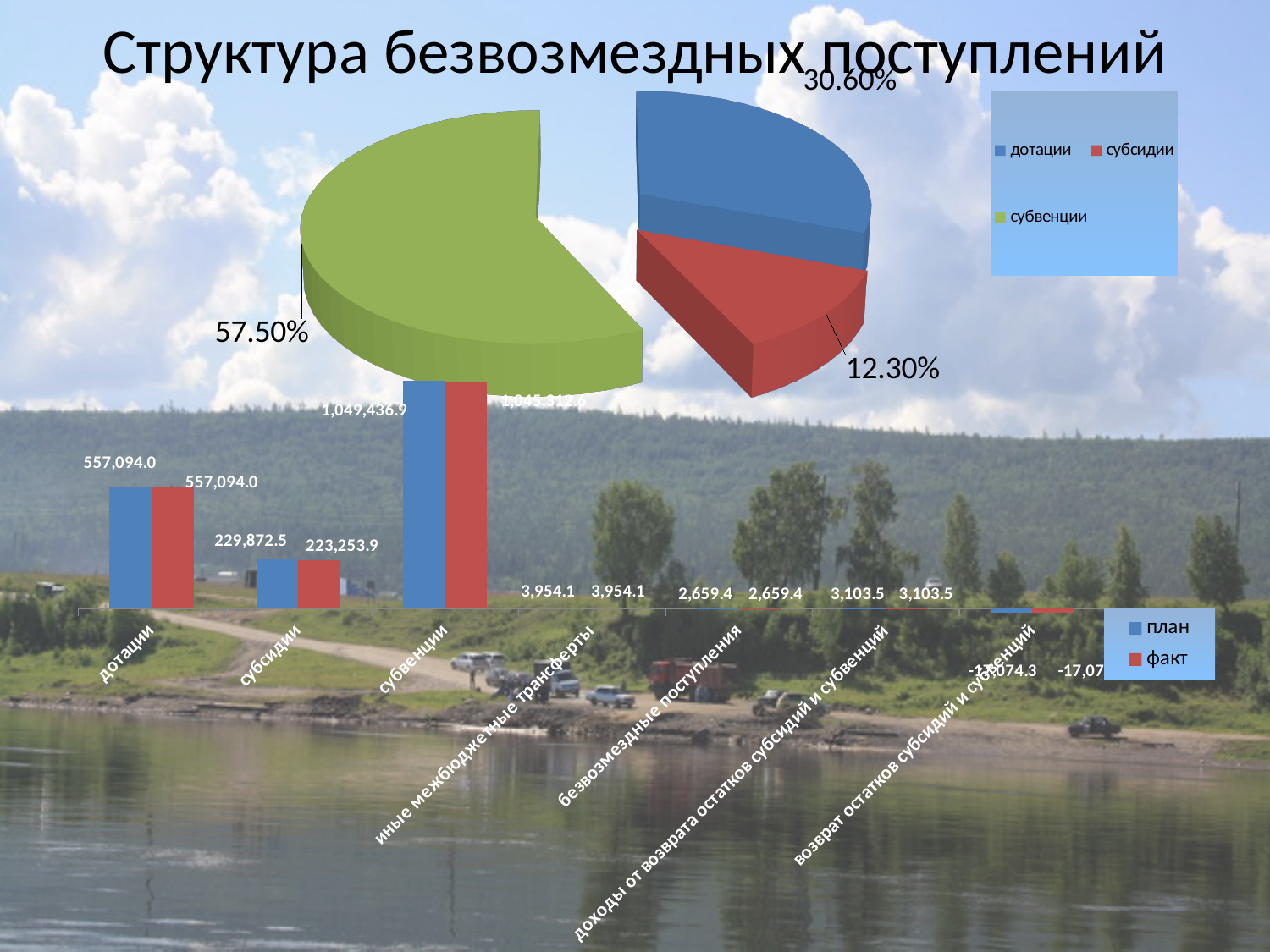
How many entries does the legend of the pie chart list? 3 In the pie chart, what share is shown for дотации? 30.60% In the pie chart, what share is shown for субвенции? 57.50% What kind of chart is the lower chart on the slide? bar chart In the bar chart, what is the факт value for субсидии? 223,253.9 In the bar chart, which category has the highest план value? субвенции In the pie chart, which category has the smallest slice? субсидии In the bar chart, what is the факт value for иные межбюджетные трансферты? 3,954.1 In the pie chart, which category has the largest slice? субвенции In the bar chart, what is the план value for субсидии? 229,872.5 In the bar chart, how many series does the legend list? 2 In the bar chart, what is the план value for дотации? 557,094.0